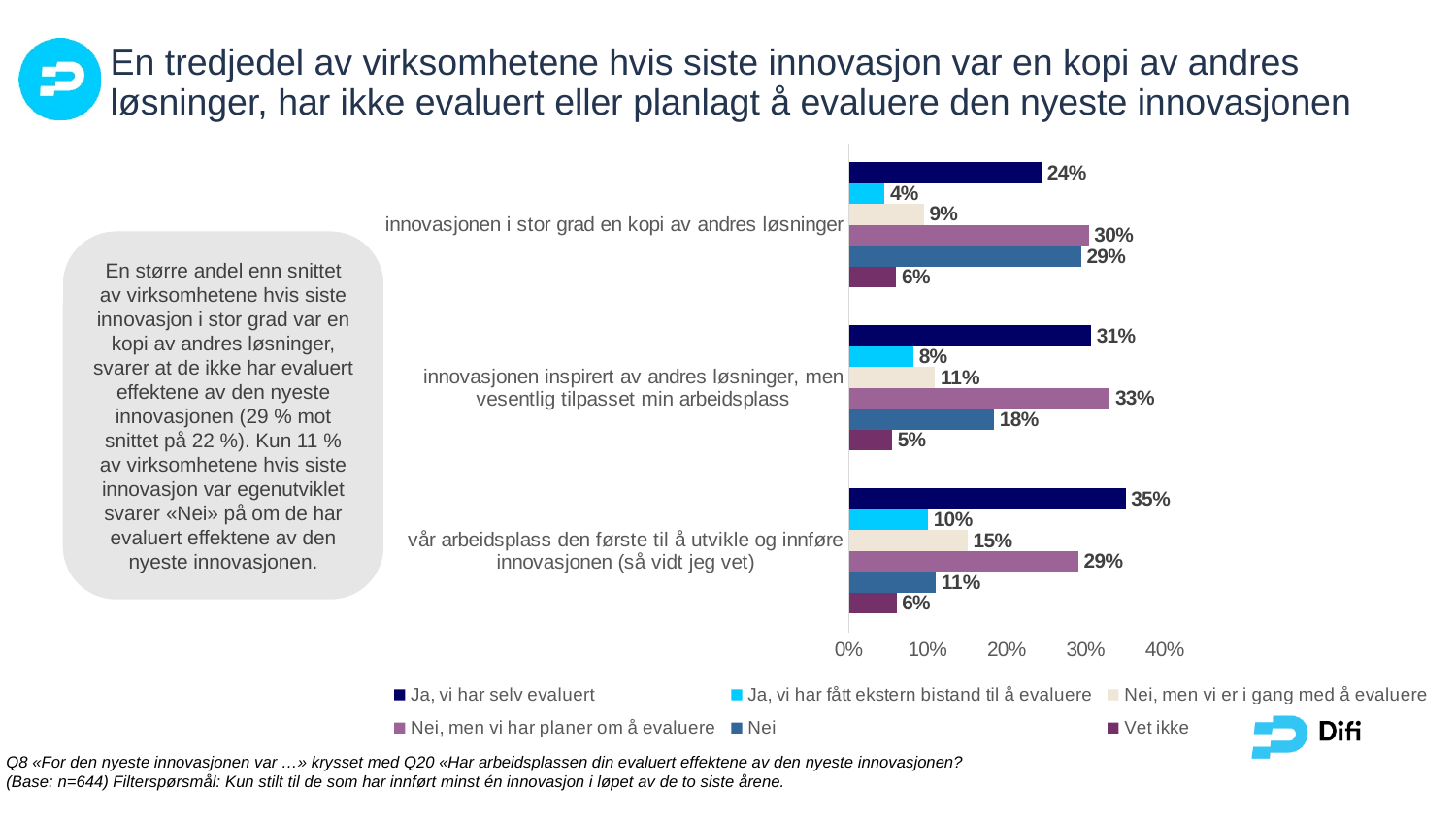
Which category has the highest value for "Nei, men vi har planer om å evaluere"? innovasjonen inspirert av andres løsninger, men vesentlig tilpasset min arbeidsplass Which category has the lowest value for "Ja, vi har selv evaluert"? innovasjonen i stor grad en kopi av andres løsninger What is the value for "Vet ikke" in the category "innovasjonen inspirert av andres løsninger, men vesentlig tilpasset min arbeidsplass"? 5% What is the value for "Nei" in the category "innovasjonen i stor grad en kopi av andres løsninger"? 29% How many categories are shown on the chart? 3 What is the value for "Ja, vi har selv evaluert" in the category "vår arbeidsplass den første til å utvikle og innføre innovasjonen (så vidt jeg vet)"? 35% Is the value for "Nei" in the category "innovasjonen inspirert av andres løsninger, men vesentlig tilpasset min arbeidsplass" greater or less than 20%? less What kind of chart is shown on the slide? Bar chart What is the value for "Ja, vi har fått ekstern bistand til å evaluere" in the category "innovasjonen inspirert av andres løsninger, men vesentlig tilpasset min arbeidsplass"? 8% How many series does the legend list? 6 What is the difference between the "Nei" values for "innovasjonen i stor grad en kopi av andres løsninger" and "vår arbeidsplass den første til å utvikle og innføre innovasjonen (så vidt jeg vet)"? 18 percentage points Which is larger: "Ja, vi har selv evaluert" or "Nei, men vi har planer om å evaluere" in the category "innovasjonen i stor grad en kopi av andres løsninger"? Nei, men vi har planer om å evaluere